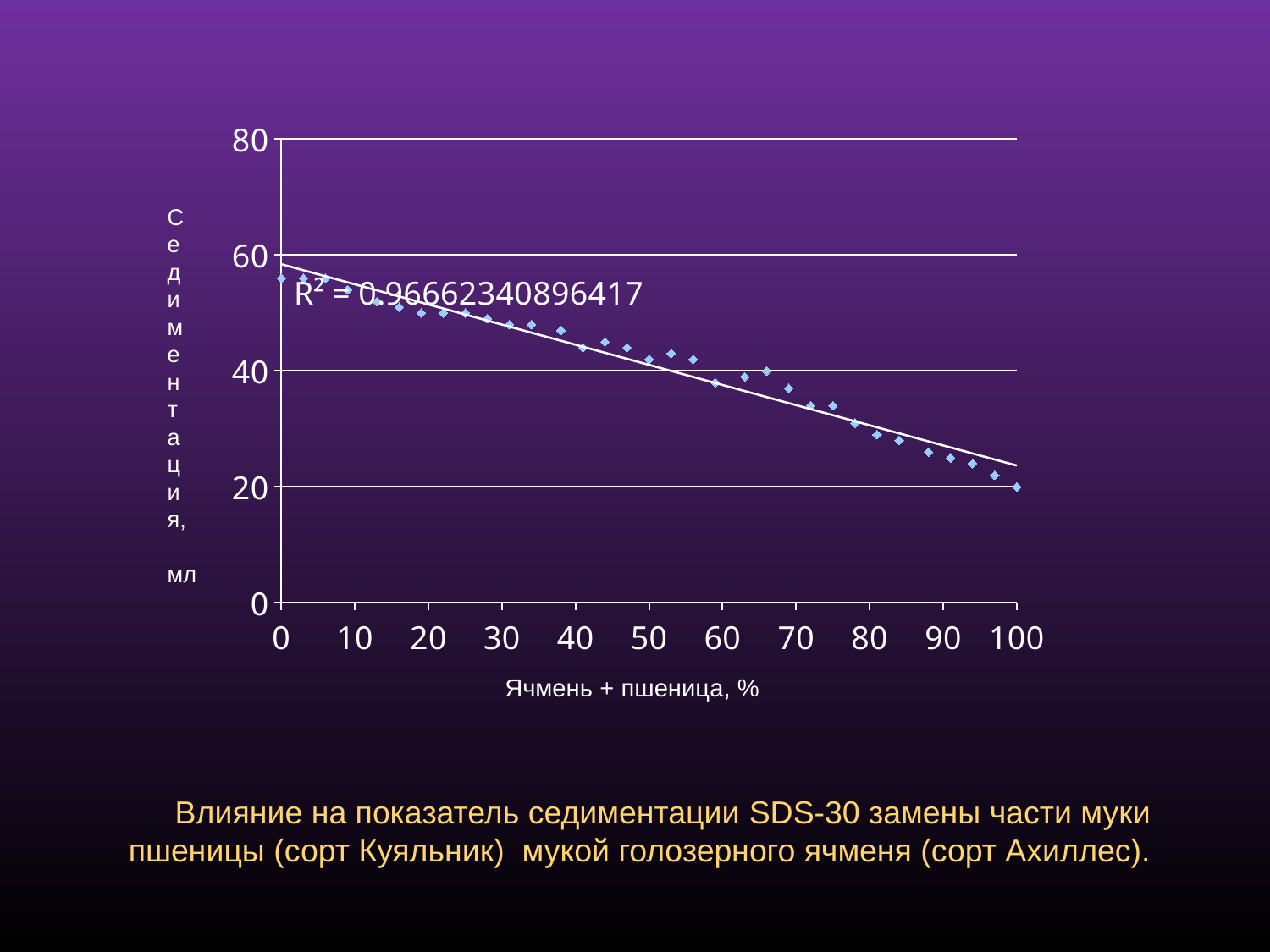
What is the maximum value shown on the y axis? 80 Is the sedimentation value at 80% barley greater or less than 40? less What kind of chart is shown on the slide? scatter chart Which is larger, the sedimentation value at 30% barley or at 70% barley? 30% barley Is the sedimentation value at 20% barley greater or less than 40? greater What is the title of the x axis? Ячмень + пшеница, % Is the sedimentation value at 0% barley greater or less than 40? greater Do the sedimentation values rise or fall as the barley share increases along the x axis? fall At which x value is the sedimentation highest, 0% or 100%? 0% What R² value is printed on the chart? 0.96662340896417